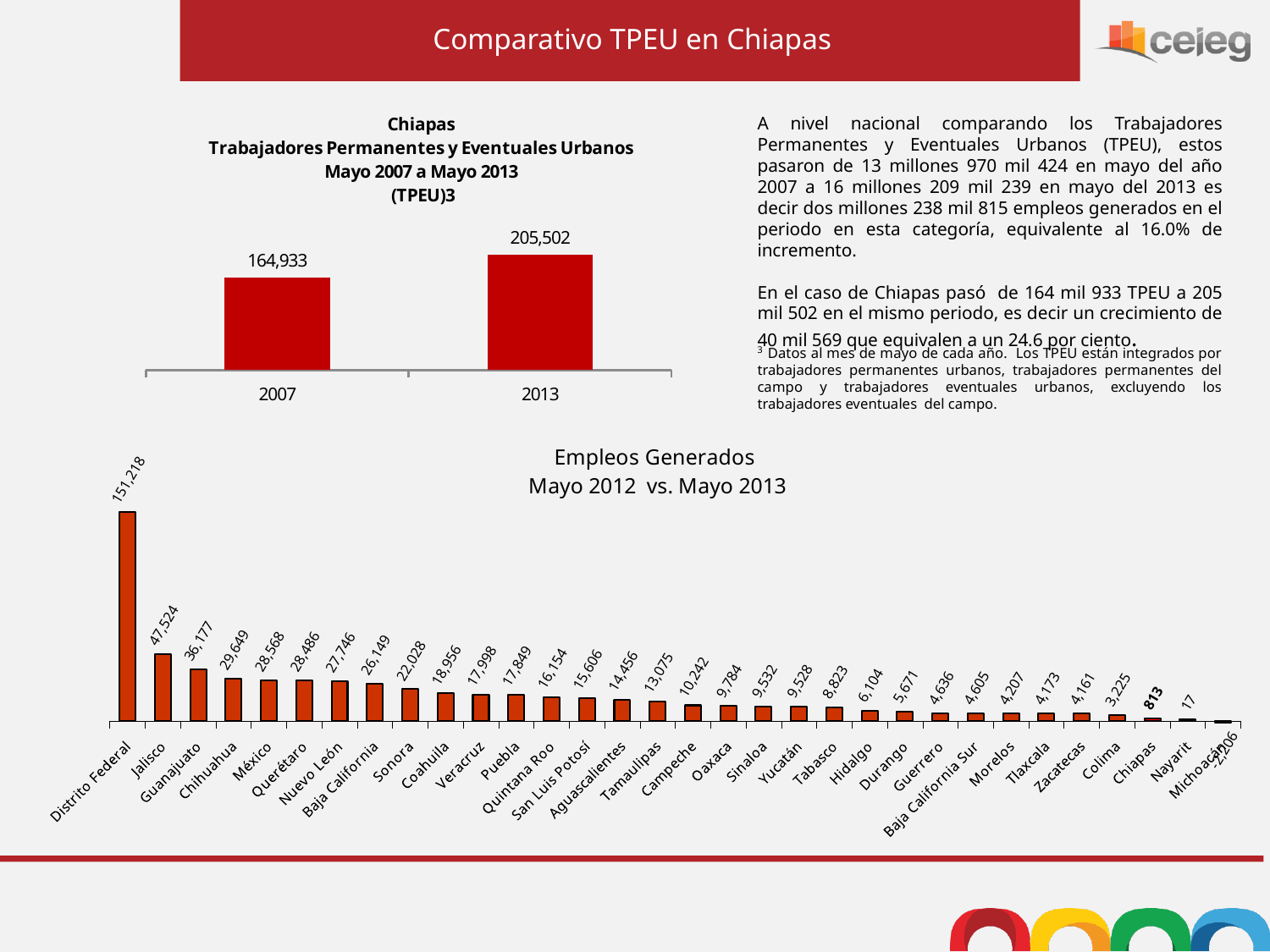
In the bottom chart 'Empleos Generados Mayo 2012 vs. Mayo 2013', what is the value for Chiapas? 813 In the bottom chart 'Empleos Generados Mayo 2012 vs. Mayo 2013', do the values generally rise or fall from left to right? Fall In the bottom chart 'Empleos Generados Mayo 2012 vs. Mayo 2013', what is the difference between the values for Colima and Chiapas? 2,412 In the bottom chart 'Empleos Generados Mayo 2012 vs. Mayo 2013', which state has the highest value? Distrito Federal In the bottom chart 'Empleos Generados Mayo 2012 vs. Mayo 2013', what is the value for Jalisco? 47,524 In the top chart 'Chiapas Trabajadores Permanentes y Eventuales Urbanos', how many bars are plotted? 2 In the top chart 'Chiapas Trabajadores Permanentes y Eventuales Urbanos', what is the value for 2013? 205,502 What kind of chart is the top chart 'Chiapas Trabajadores Permanentes y Eventuales Urbanos'? Bar chart In the top chart 'Chiapas Trabajadores Permanentes y Eventuales Urbanos', what is the difference between the 2013 and 2007 values? 40,569 In the top chart 'Chiapas Trabajadores Permanentes y Eventuales Urbanos', what is the value for 2007? 164,933 In the bottom chart 'Empleos Generados Mayo 2012 vs. Mayo 2013', which is larger, the value for Guanajuato or the value for Chihuahua? Guanajuato In the bottom chart 'Empleos Generados Mayo 2012 vs. Mayo 2013', what is the value for Nuevo León? 27,746